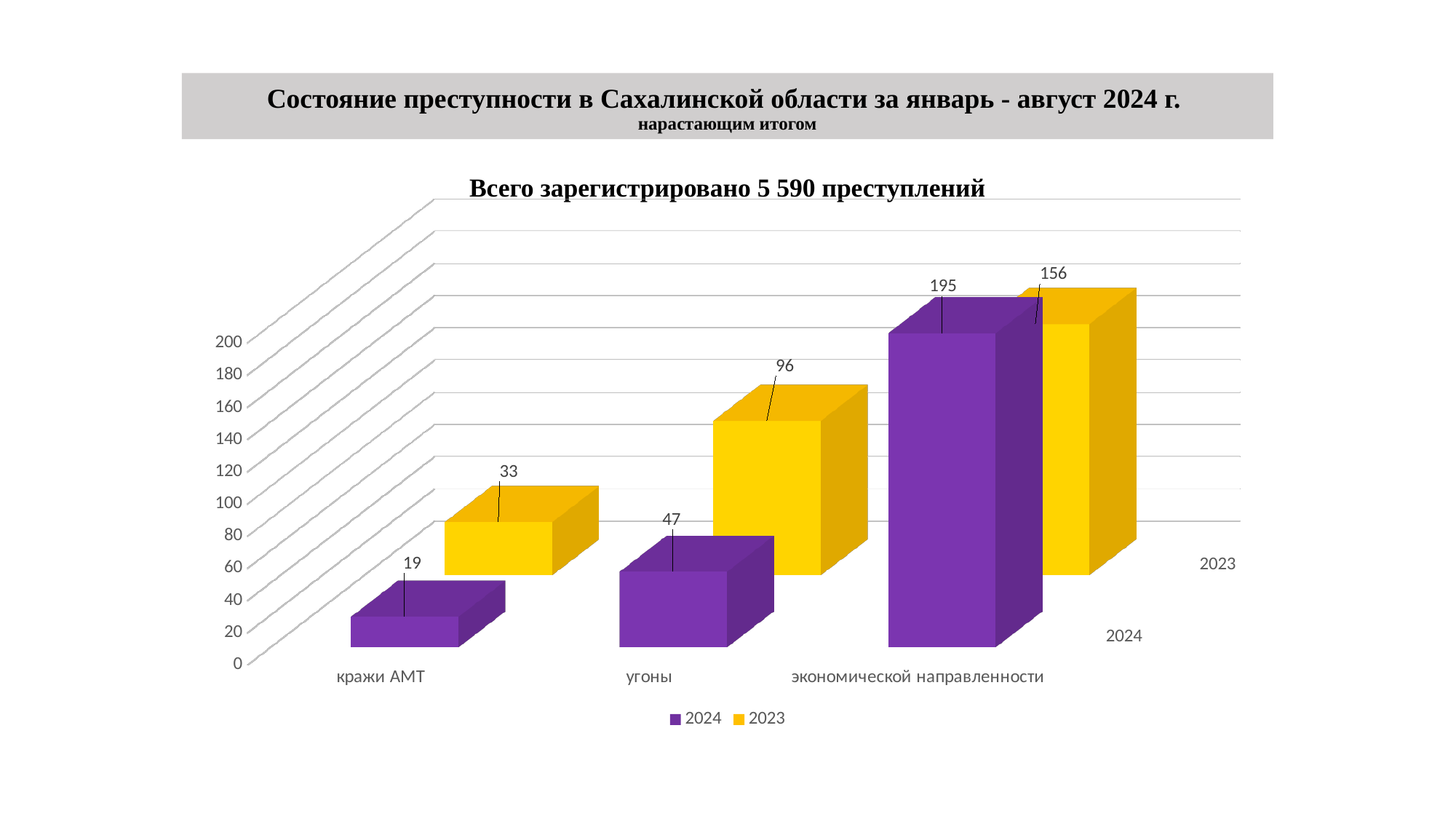
What is the value for 2024 in the category "кражи АМТ"? 19 What is the difference between the 2024 and 2023 values for "экономической направленности"? 39 How many series does the legend list? 2 How many categories are shown on the x axis? 3 Which category has the lowest value for the 2023 series? кражи АМТ What is the value for 2024 in the category "экономической направленности"? 195 Which category has the highest value for the 2024 series? экономической направленности Which is larger for "угоны": the 2024 value or the 2023 value? 2023 What is the value for 2023 in the category "кражи АМТ"? 33 What kind of chart is shown on the slide? bar chart What is the title of the chart? Всего зарегистрировано 5 590 преступлений What is the value for 2023 in the category "угоны"? 96